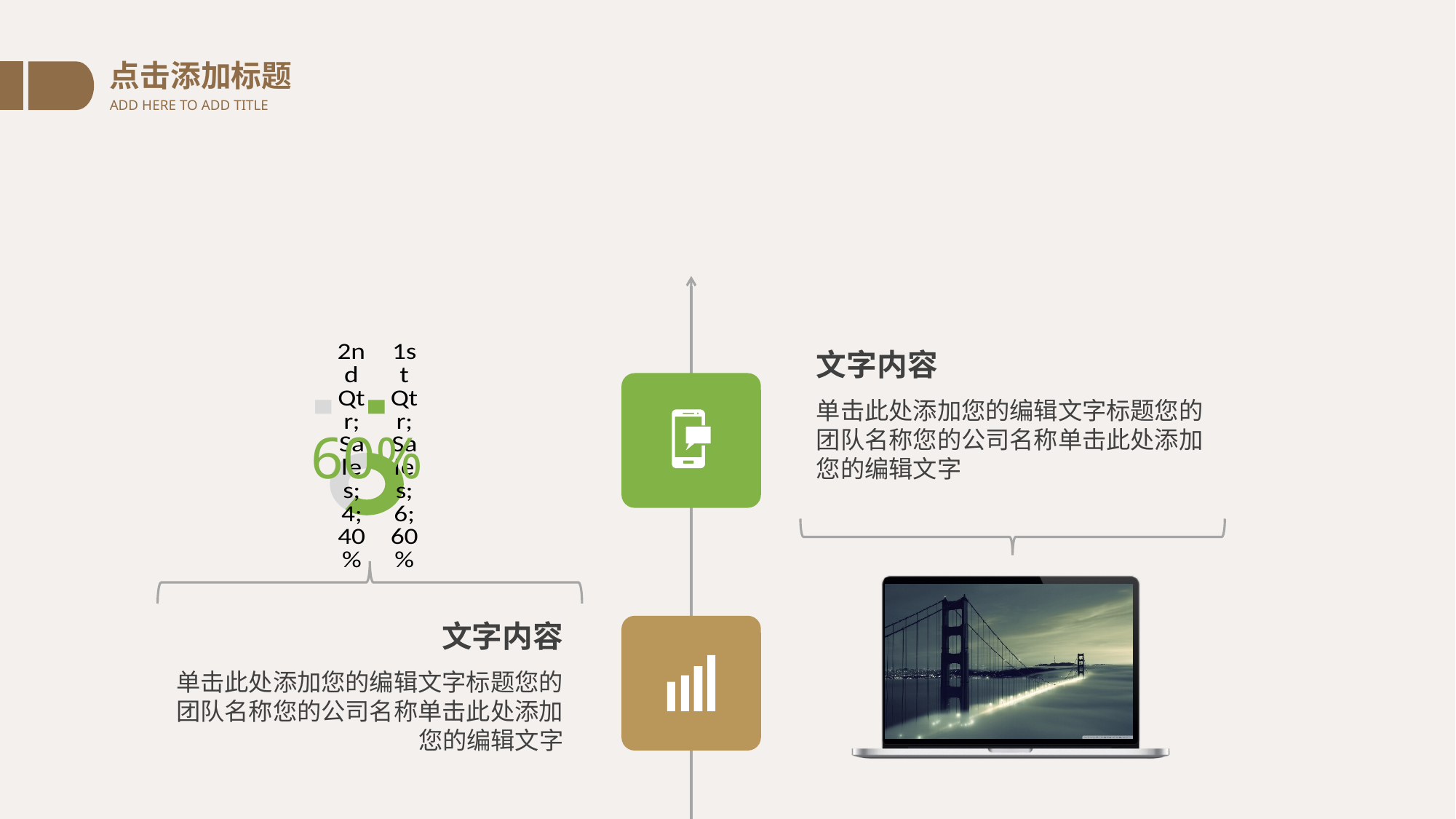
What percentage share does 1st Qtr have in the chart? 60% What colour is the 1st Qtr segment in the chart? green What is the name of the data series in the chart? Sales Which category has the smaller share in the chart? 2nd Qtr What is the total of the Sales values for the two quarters? 10 Which category has the larger share in the chart? 1st Qtr What is the Sales value for 2nd Qtr shown in the chart legend? 4 What is the difference between the Sales values for 1st Qtr and 2nd Qtr? 2 Is the share for 1st Qtr larger or smaller than the share for 2nd Qtr? larger How many categories does the chart show? 2 What is the Sales value for 1st Qtr shown in the chart legend? 6 What percentage share does 2nd Qtr have in the chart? 40%